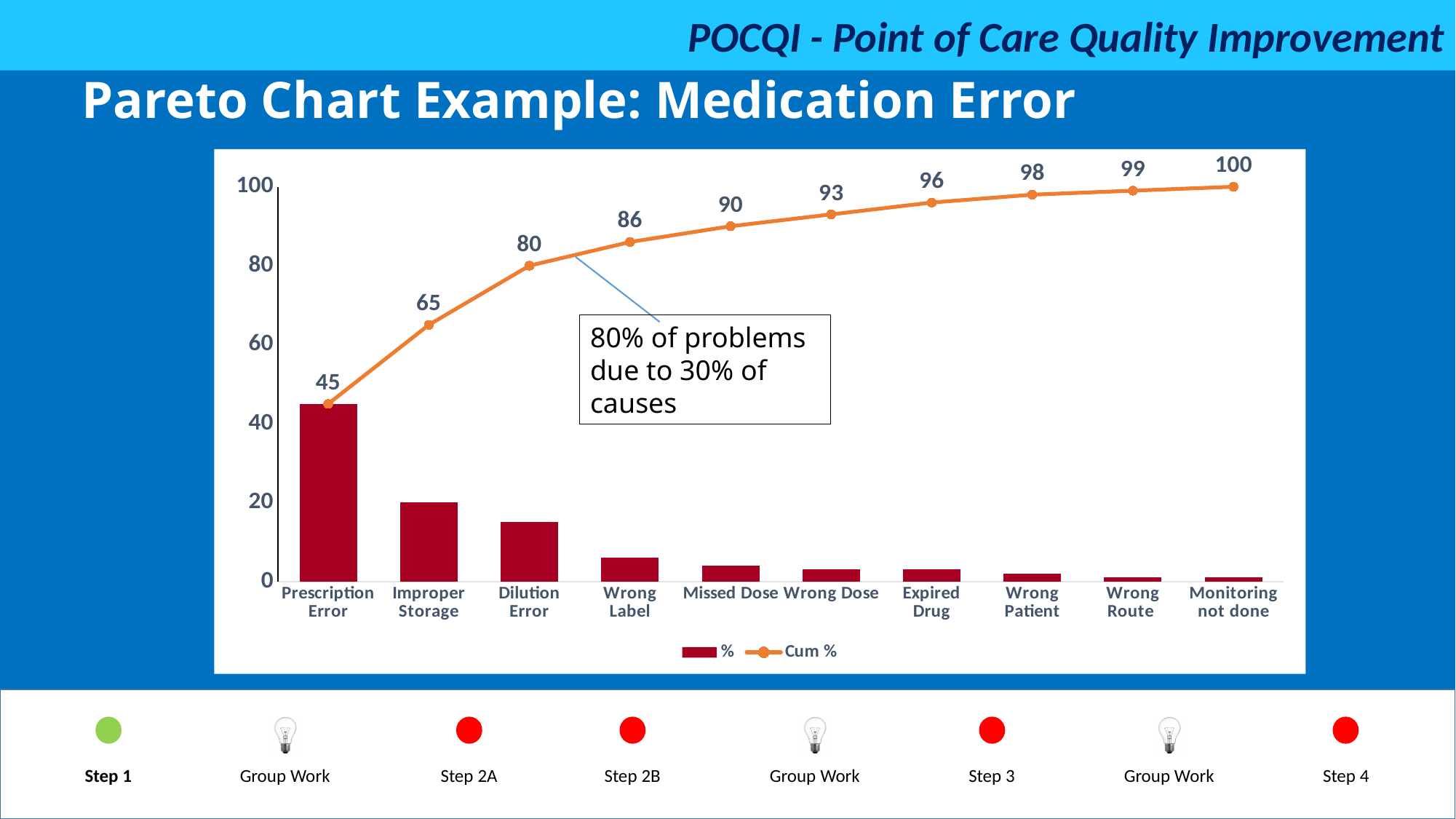
How many categories are shown on the x axis? 10 What is the Cum % value for Improper Storage? 65 What is the Cum % value for Dilution Error? 80 What is the Cum % value for Missed Dose? 90 What is the Cum % value for Wrong Patient? 98 Does the Cum % line rise or fall from left to right? rises Is the % bar for Prescription Error greater or less than 40? greater Which category has the highest % bar? Prescription Error What does the text box annotation on the chart say? 80% of problems due to 30% of causes What is the difference between the Cum % values for Wrong Label and Dilution Error? 6 Is the % bar for Improper Storage greater or less than 40? less How many series does the legend list? 2